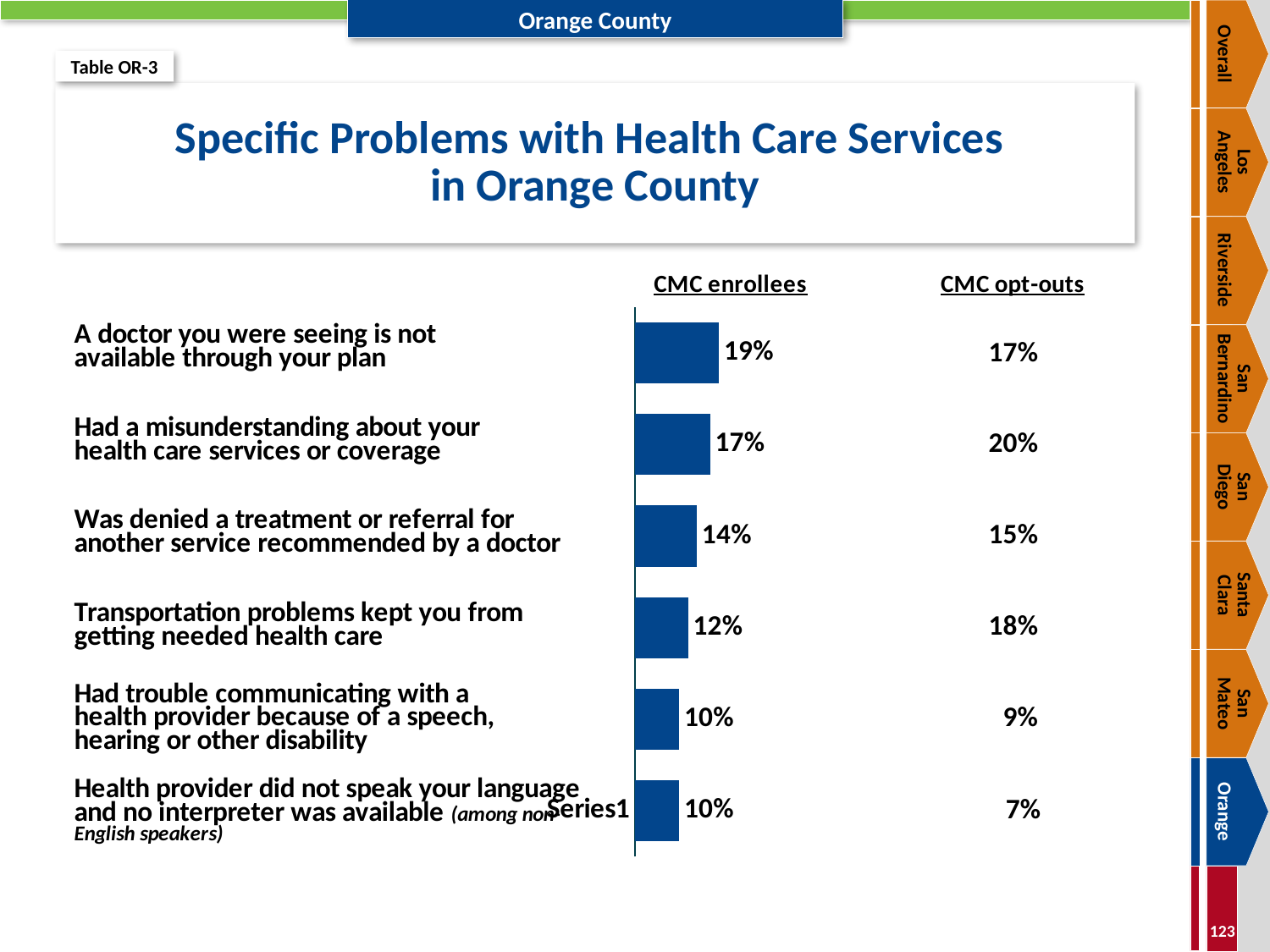
What is the CMC enrollees value for "Was denied a treatment or referral for another service recommended by a doctor"? 14% What is the difference between the CMC enrollees values for "A doctor you were seeing is not available through your plan" and "Was denied a treatment or referral for another service recommended by a doctor"? 5 percentage points What is the CMC enrollees value for "Transportation problems kept you from getting needed health care"? 12% How many bars are plotted in the chart? 6 What is the title of the chart on the slide? Specific Problems with Health Care Services in Orange County Do the CMC enrollees bar values rise or fall going from the top bar to the bottom bar? fall What is the difference between the CMC enrollees and CMC opt-outs values for "Transportation problems kept you from getting needed health care"? 6 percentage points Which is larger for CMC enrollees: "Had a misunderstanding about your health care services or coverage" or "Transportation problems kept you from getting needed health care"? Had a misunderstanding about your health care services or coverage Which problem has the highest CMC enrollees value in the bar chart? A doctor you were seeing is not available through your plan What kind of chart is shown on the slide? bar chart What is the CMC enrollees value for "A doctor you were seeing is not available through your plan"? 19% What is the CMC opt-outs value printed for "Had a misunderstanding about your health care services or coverage"? 20%